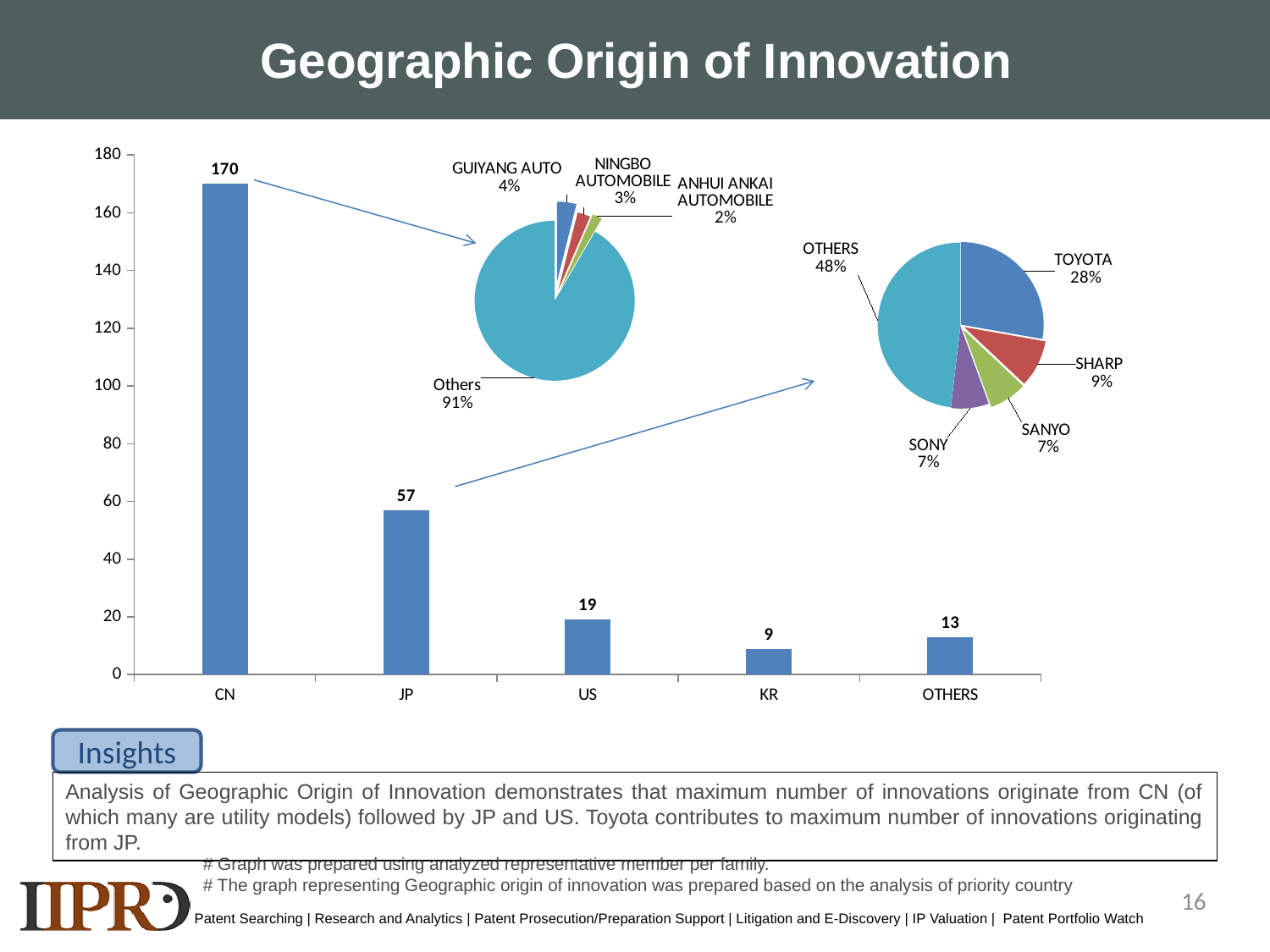
What kind of chart is the chart on the left with the country categories? Bar chart In the upper-middle pie chart, what share does Others have? 91% In the right-hand pie chart, what share does TOYOTA have? 28% In the upper-middle pie chart, what share does GUIYANG AUTO have? 4% In the bar chart, what is the difference between the values for CN and JP? 113 In the right-hand pie chart, which slice is the largest? OTHERS How many categories are shown in the bar chart? 5 In the bar chart, which category has the lowest value? KR In the bar chart, which category has the highest value? CN In the bar chart, what is the value for JP? 57 In the bar chart, which is larger, the value for US or the value for OTHERS? US In the bar chart, what is the value for CN? 170